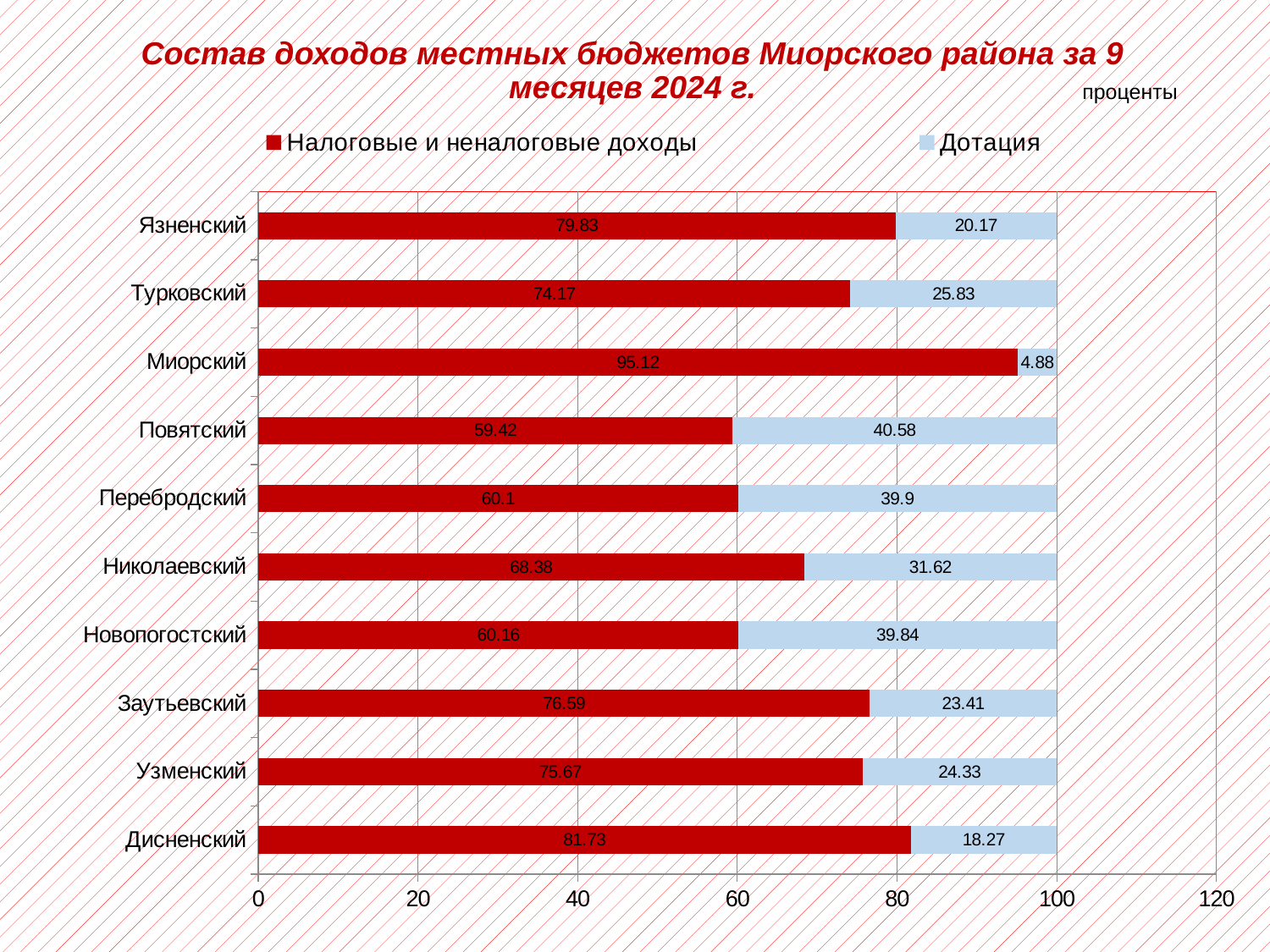
What kind of chart is shown on the slide? Stacked bar chart Which category has the highest value for Налоговые и неналоговые доходы? Миорский What is the difference between Налоговые и неналоговые доходы and Дотация for Язненский? 59.66 Which is larger: Налоговые и неналоговые доходы for Турковский or for Узменский? Узменский What is the total of the stacked bar for Николаевский? 100 Which category has the highest value for Дотация? Повятский How many series does the legend list? 2 How many categories are shown on the chart? 10 Which category has the lowest value for Дотация? Миорский What is the value of Дотация for Дисненский? 18.27 What is the value of Дотация for Повятский? 40.58 What is the value of Налоговые и неналоговые доходы for Миорский? 95.12